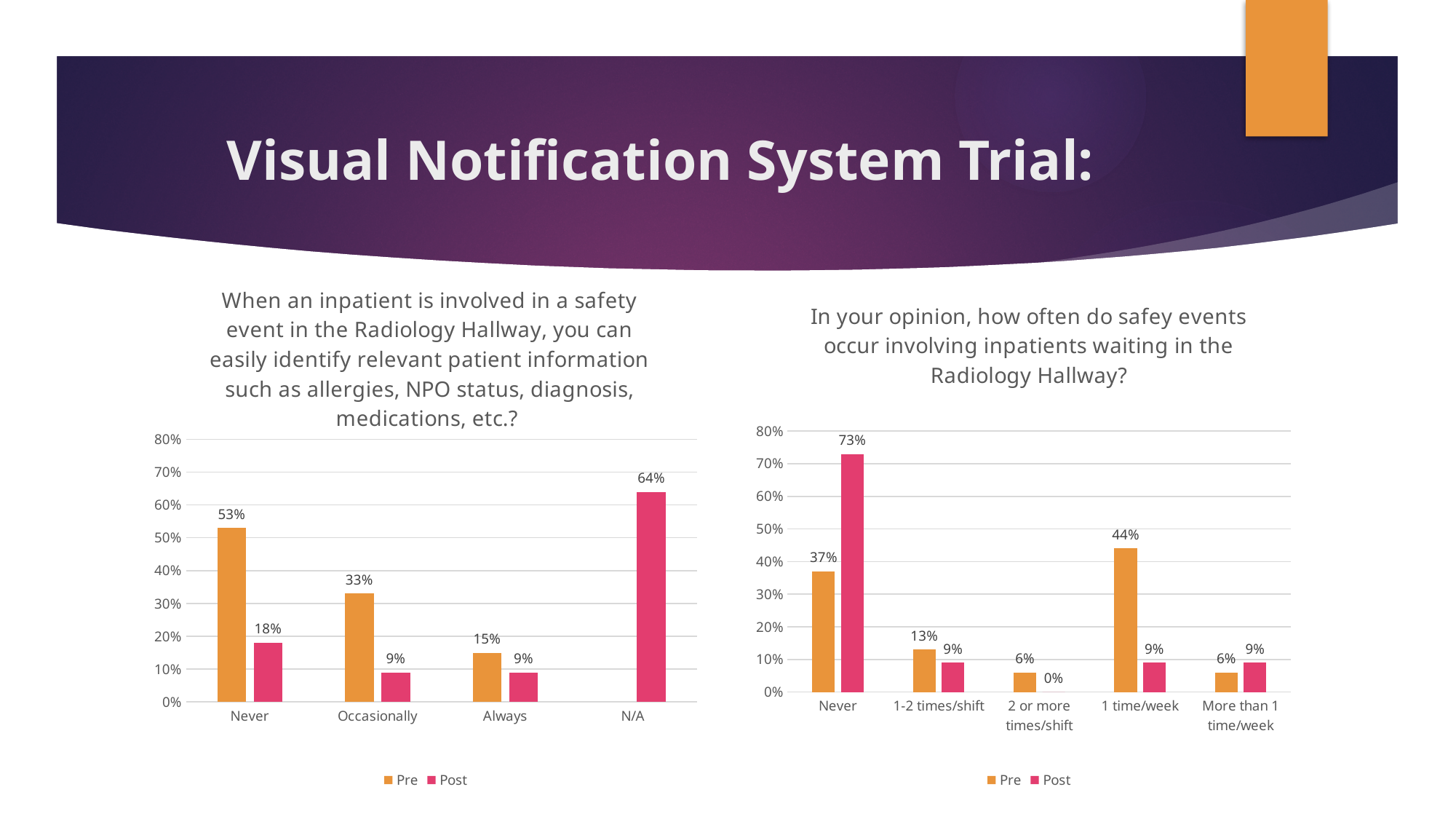
In the right chart, what is the Pre value for 1 time/week? 44% In the right chart, what is the Post value for Never? 73% What type of chart is the left chart? Bar chart How many series does the legend of the right chart list? 2 In the left chart, which category has the highest Post value? N/A In the right chart, what is the difference between the Post and Pre values for Never? 36% In the left chart, what is the difference between the Pre and Post values for Never? 35% In the left chart, how many categories are shown on the x axis? 4 In the left chart, what is the Pre value for Never? 53% In the left chart, what is the Post value for N/A? 64% In the right chart, which is larger for 1-2 times/shift, the Pre value or the Post value? Pre In the right chart, which category has the lowest Post value? 2 or more times/shift